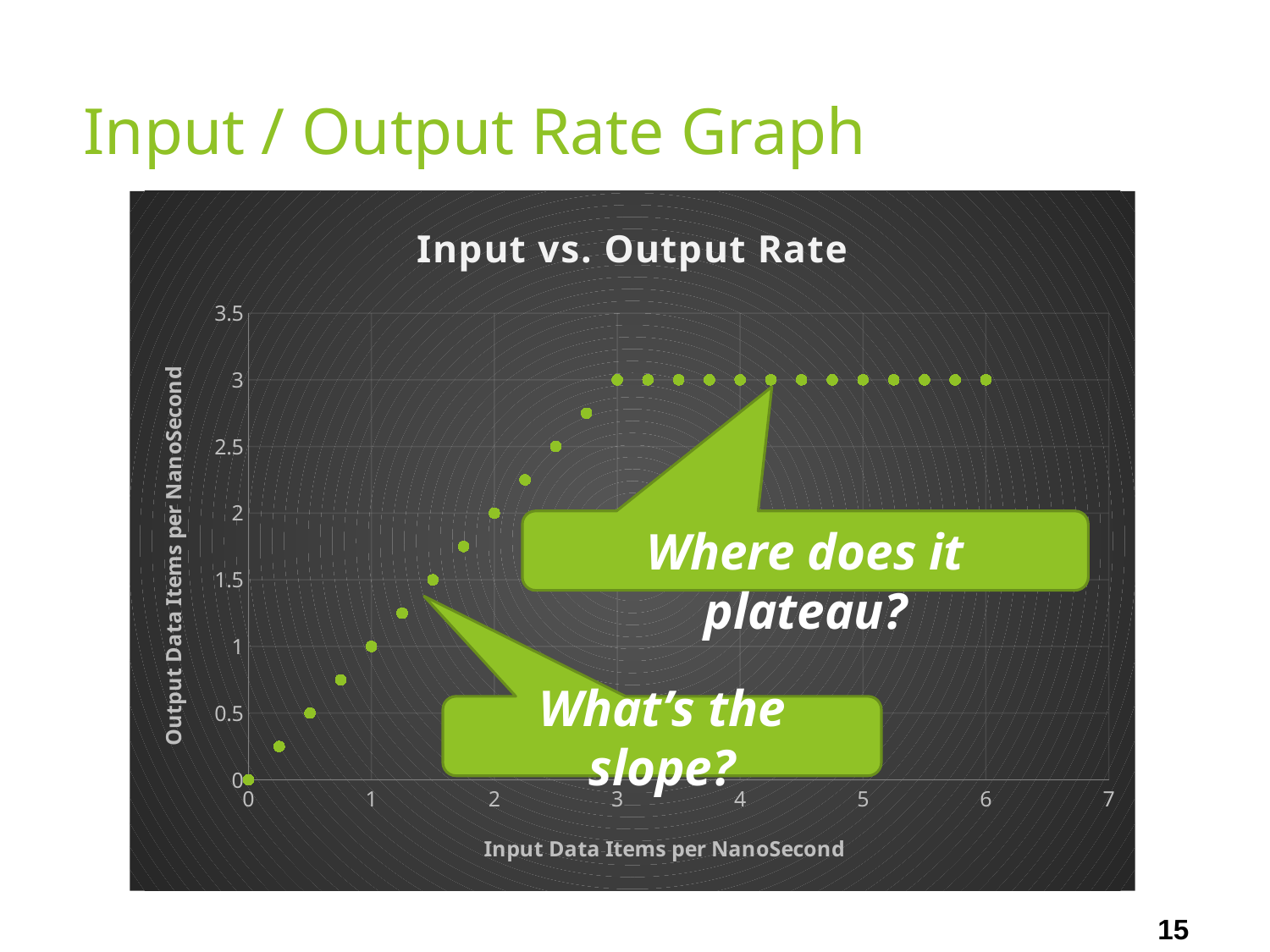
Which has the larger output rate: an input rate of 1 or an input rate of 2? input rate of 2 What is the title of the chart? Input vs. Output Rate What is the output rate when the input rate is 1? 1 What is the output rate when the input rate is 5? 3 What is the highest output rate reached on the chart? 3 How does the output rate change as the input rate increases along the x axis? rises until input rate 3, then stays flat at 3 Is the output rate at an input rate of 2.5 greater or less than 2? greater What is the output rate when the input rate is 2? 2 What is the difference between the output rate at input rate 3 and the output rate at input rate 1? 2 What is the label of the x axis? Input Data Items per NanoSecond What kind of chart is shown on the slide? scatter chart Is the output rate at an input rate of 0.5 greater or less than 1? less